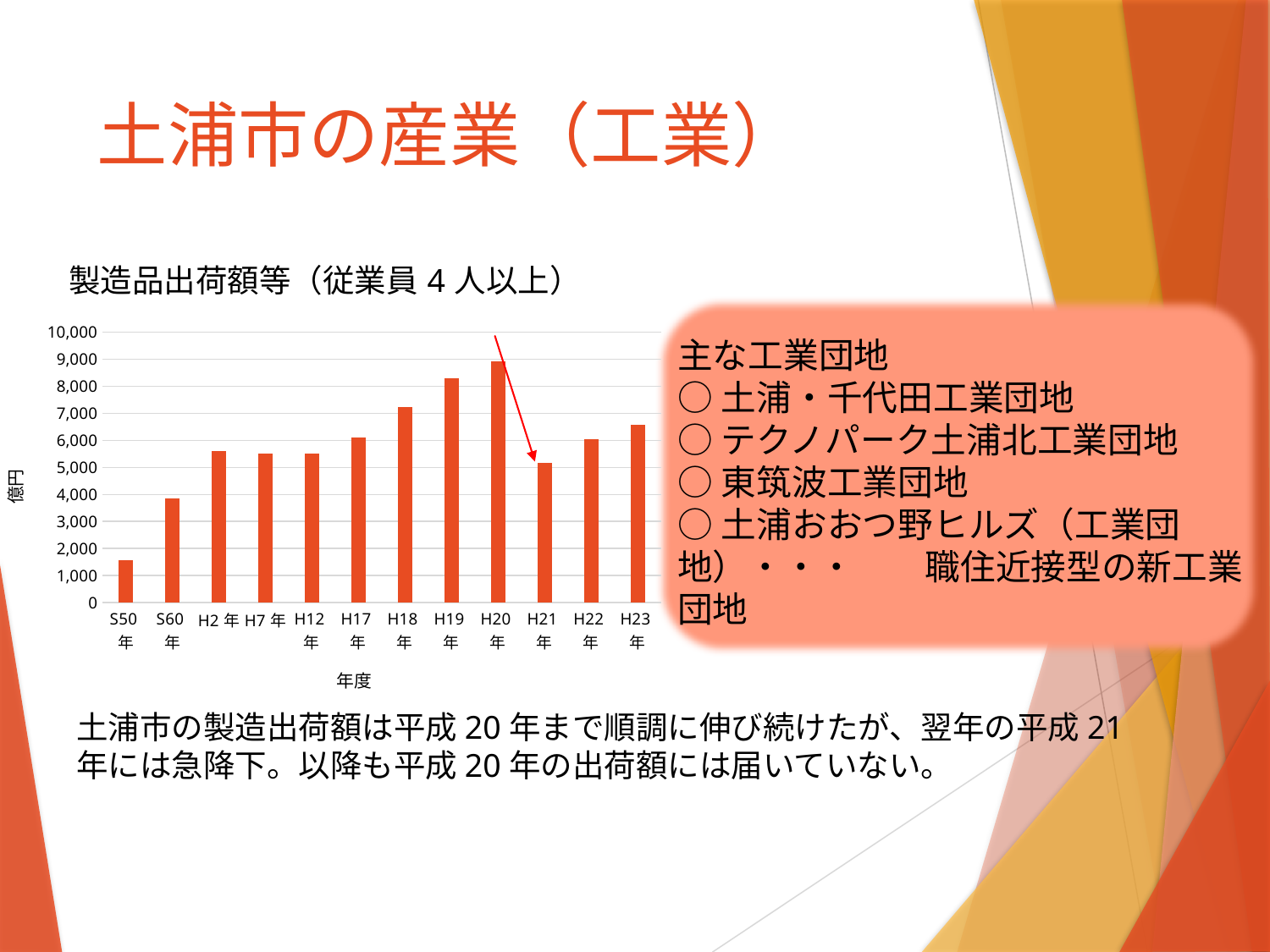
What kind of chart is shown on the slide? Bar chart Do the values rise or fall from S50年 to H20年? Rise How many years (categories) are plotted on the x axis of the chart? 12 Is the value for S50年 greater or less than 2,000? less Which is larger, the value for H18年 or the value for H22年? H18年 What is the title of the chart? 製造品出荷額等（従業員4人以上） Is the value for H21年 greater or less than 6,000? less Which year has the highest manufactured goods shipment value in the chart? H20年 What is the label on the vertical axis of the chart? 億円 Is the value for H20年 greater or less than 8,000? greater Which year has the lowest manufactured goods shipment value in the chart? S50年